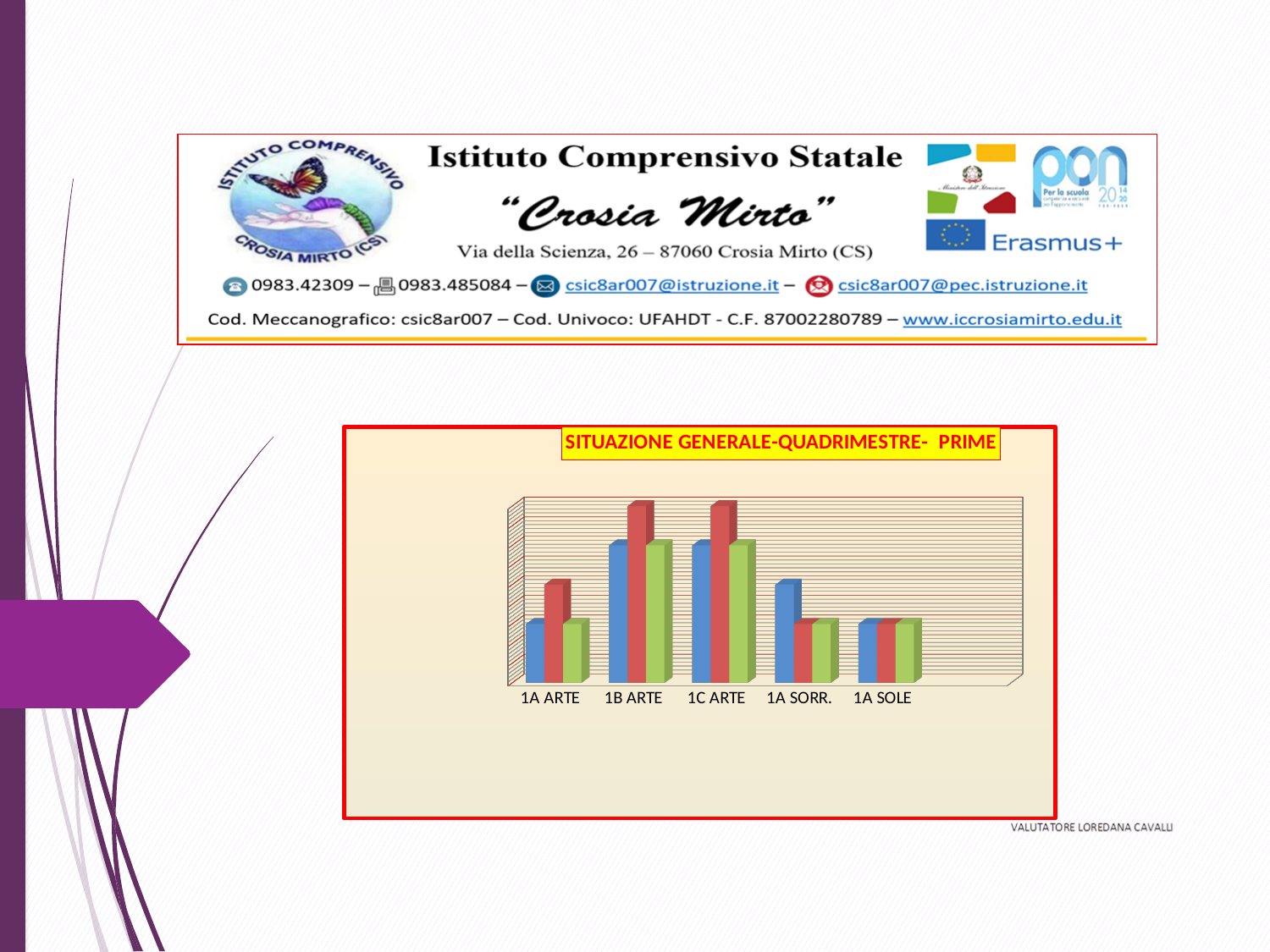
Which is taller, the blue bar for 1A SORR. or the blue bar for 1A SOLE? the blue bar for 1A SORR. What kind of chart is shown on the slide? bar chart Which is taller, the blue bar for 1B ARTE or the blue bar for 1A ARTE? the blue bar for 1B ARTE In the 1A ARTE category, which bar is taller, the blue bar or the red bar? the red bar What is the title of the chart? SITUAZIONE GENERALE-QUADRIMESTRE- PRIME How many bars are plotted for each category in the chart? 3 How many categories are shown on the x axis of the chart? 5 What is the label of the first category on the x axis of the chart? 1A ARTE What colours are the three bars in each category of the chart? blue, red and green